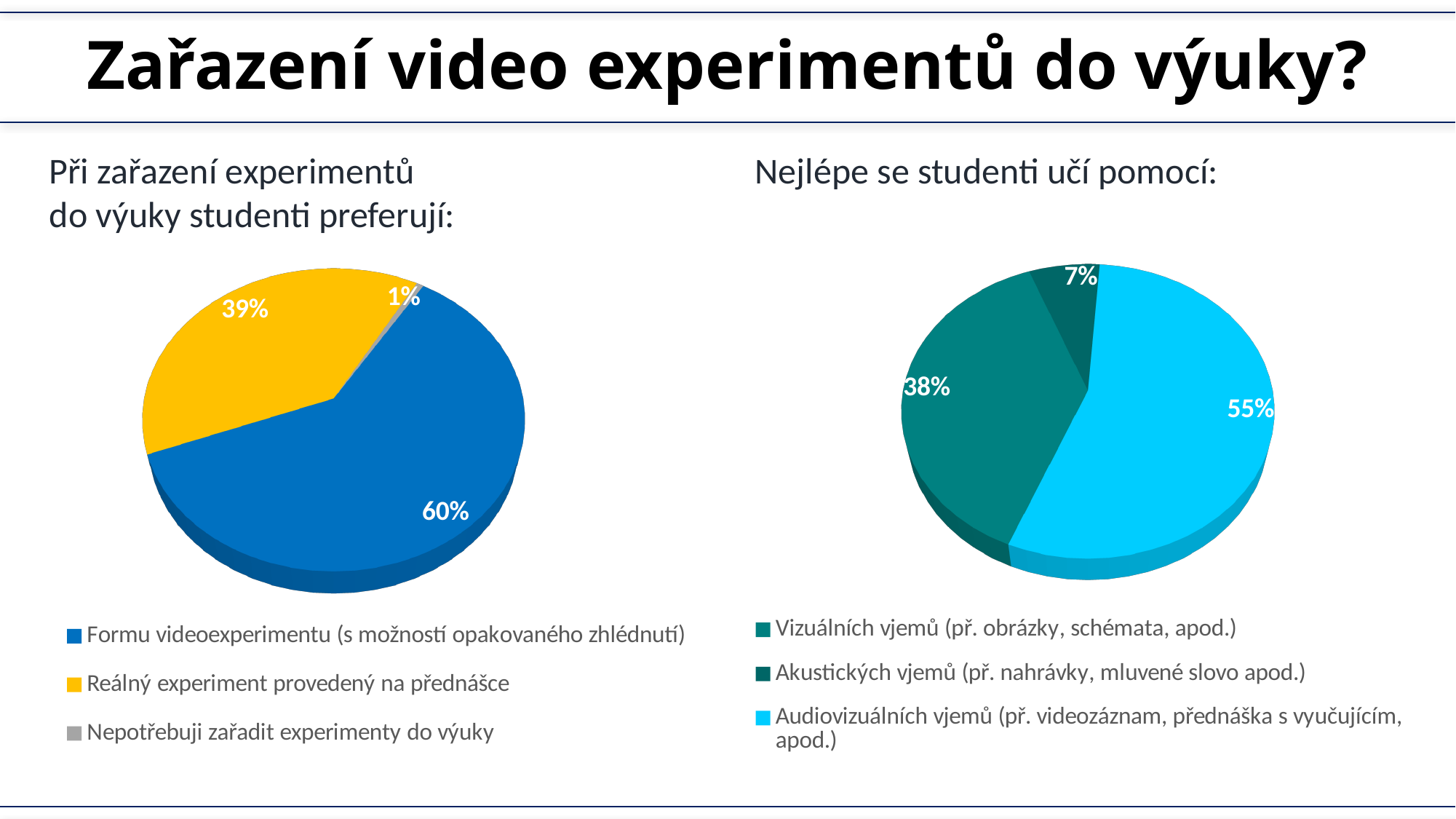
What type of chart is used on the left side of the slide? Pie chart In the left pie chart, which category has the smallest share? Nepotřebuji zařadit experimenty do výuky In the left pie chart, what share of students prefer 'Formu videoexperimentu (s možností opakovaného zhlédnutí)'? 60% In the right pie chart, which category has the smallest share? Akustických vjemů (př. nahrávky, mluvené slovo apod.) In the right pie chart, what share of students learn best through 'Vizuálních vjemů'? 38% In the right pie chart, what share of students learn best through 'Akustických vjemů'? 7% In the right pie chart, what share of students learn best through 'Audiovizuálních vjemů'? 55% In the left pie chart, what share corresponds to 'Nepotřebuji zařadit experimenty do výuky'? 1% In the left pie chart, which category has the largest share? Formu videoexperimentu (s možností opakovaného zhlédnutí) In the right pie chart, how many categories does the legend list? 3 In the left pie chart, what is the difference between the shares for 'Formu videoexperimentu' and 'Reálný experiment provedený na přednášce'? 21% In the left pie chart, what share of students prefer 'Reálný experiment provedený na přednášce'? 39%